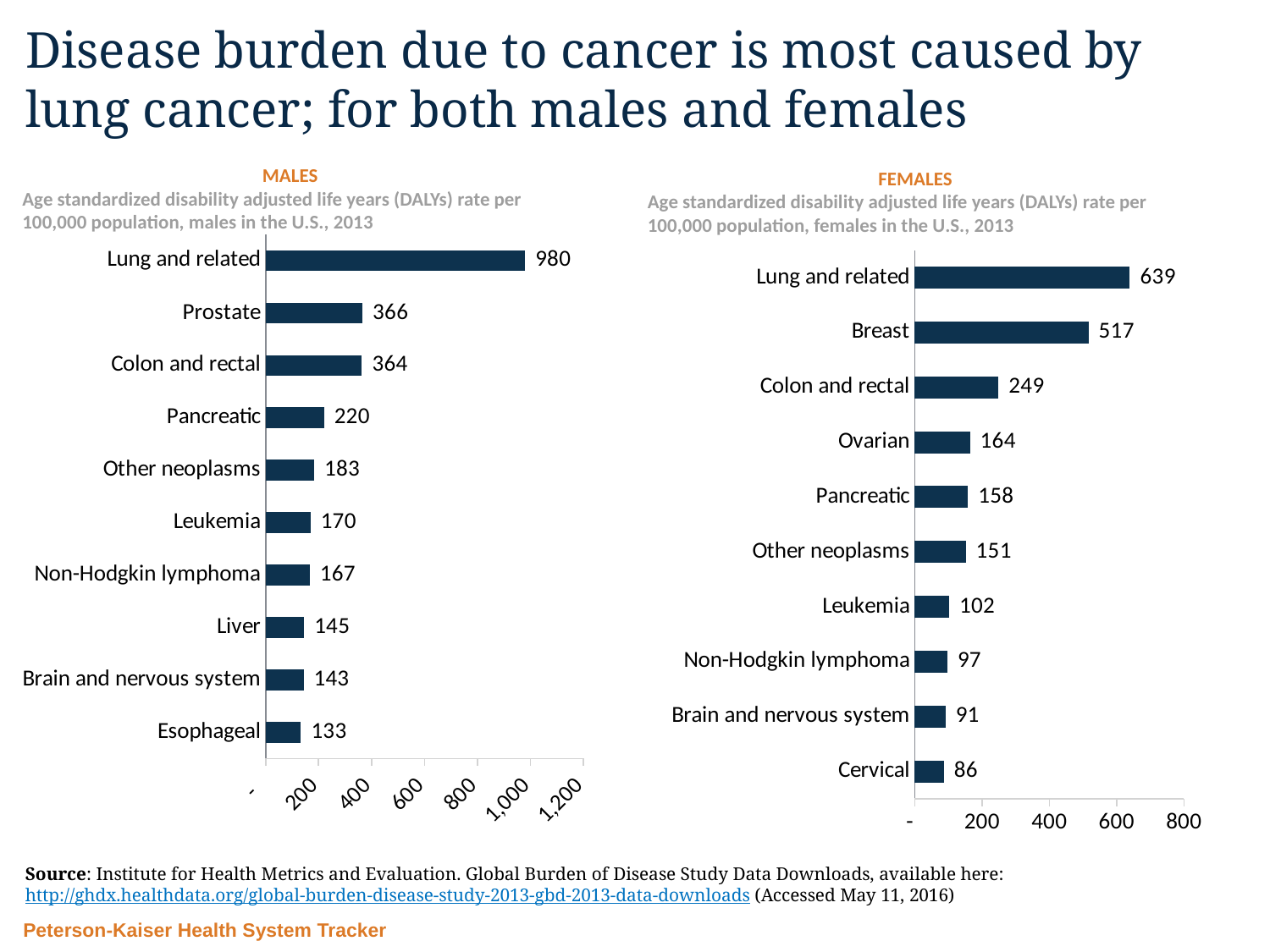
In the MALES chart, what is the DALYs rate for Lung and related cancer? 980 In the FEMALES chart, what is the difference between the values for Lung and related and Breast? 122 In the FEMALES chart, which category has the lowest value? Cervical Which is larger: the value for Colon and rectal in the MALES chart or the value for Colon and rectal in the FEMALES chart? MALES (364) How many categories are shown in the MALES chart? 10 In the MALES chart, what is the value for Pancreatic? 220 What type of chart is the FEMALES chart? Bar chart In the FEMALES chart, is the value for Ovarian greater or less than 200? less In the FEMALES chart, which category has the highest value? Lung and related In the MALES chart, which category has the lowest value? Esophageal In the MALES chart, what is the difference between the values for Lung and related and Prostate? 614 In the FEMALES chart, what is the DALYs rate for Breast cancer? 517